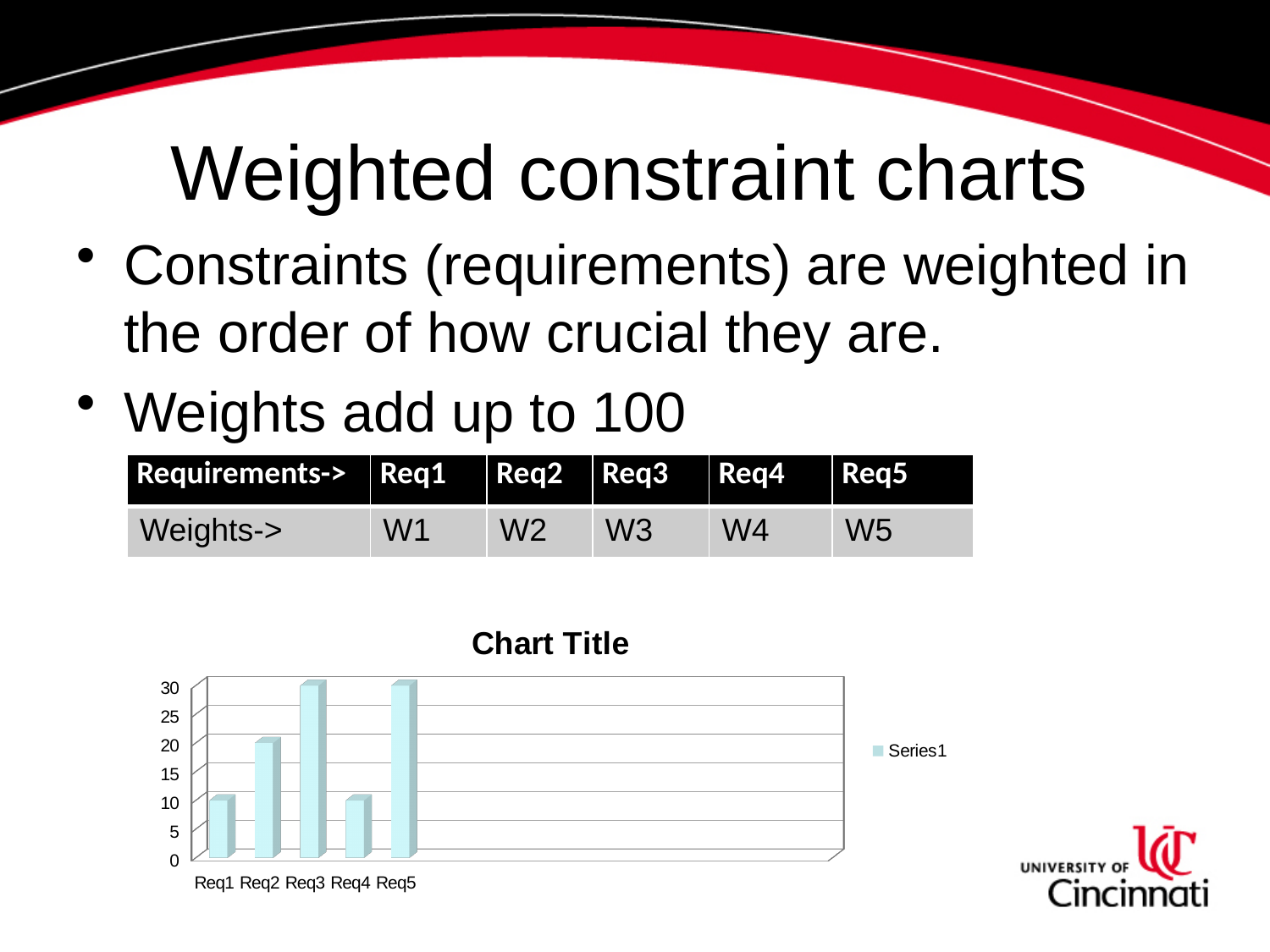
How many categories are plotted on the x axis of the chart? 5 What is the value for Req3 in the chart? 30 What is the value for Req2 in the chart? 20 What type of chart is shown on the slide? bar chart Is the value for Req4 greater or less than 15? less What is the name of the series shown in the chart's legend? Series1 What is the title of the chart? Chart Title Which has the larger value, Req3 or Req4? Req3 Is the value for Req5 greater or less than 25? greater Which has the larger value, Req2 or Req1? Req2 How many series does the chart's legend list? 1 What is the value for Req1 in the chart? 10